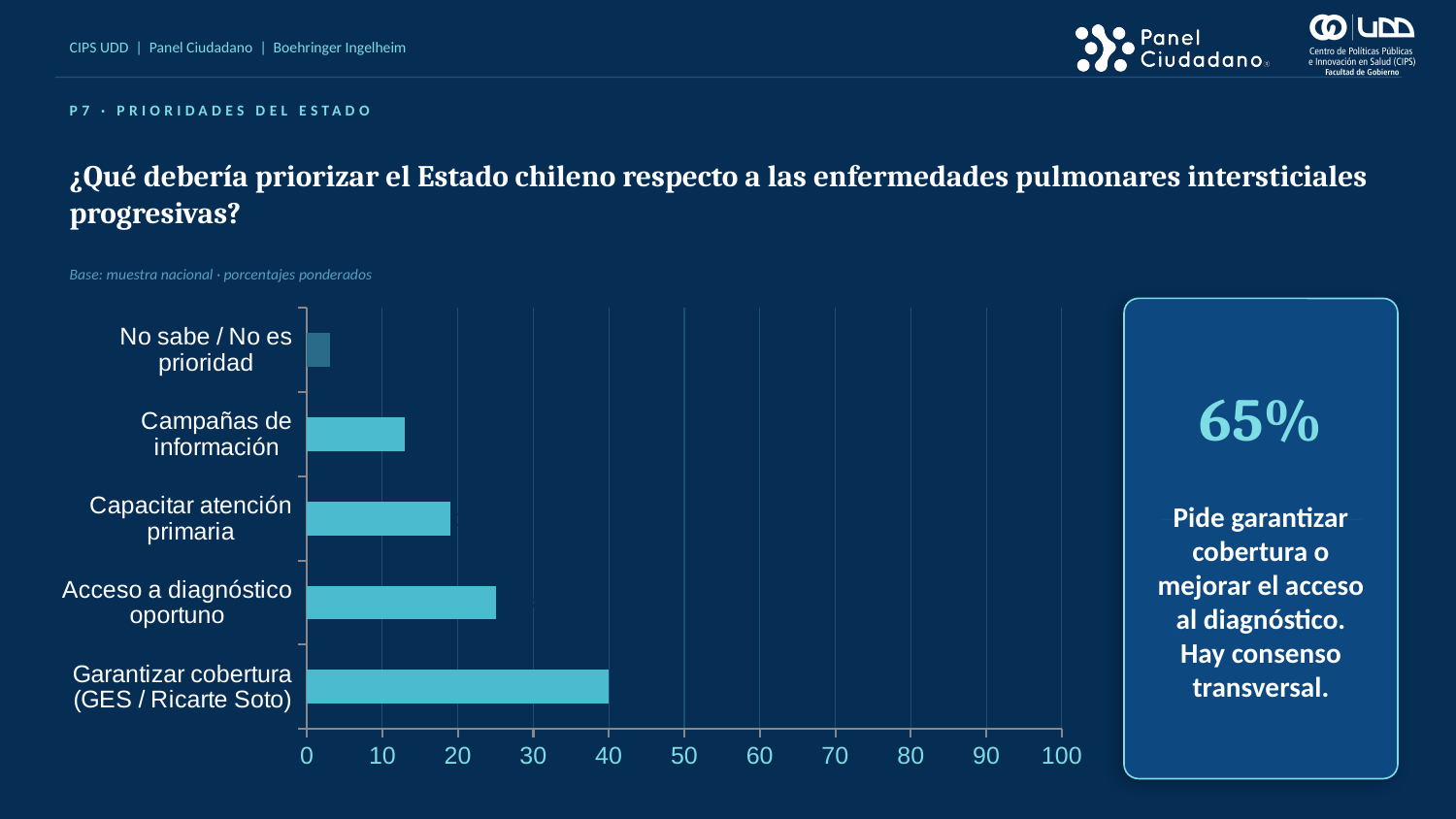
What kind of chart is shown on the slide? bar chart What percentage is highlighted in the box to the right of the chart? 65% Which category has the lowest value? No sabe / No es prioridad What is the value for Garantizar cobertura (GES / Ricarte Soto)? 40 Is the value for Acceso a diagnóstico oportuno greater or less than 20? greater Is the value for Campañas de información greater or less than 20? less Which category has the highest value? Garantizar cobertura (GES / Ricarte Soto) Which is larger, the value for Capacitar atención primaria or the value for Campañas de información? Capacitar atención primaria Is the value for Capacitar atención primaria greater or less than 10? greater How many categories are shown in the chart? 5